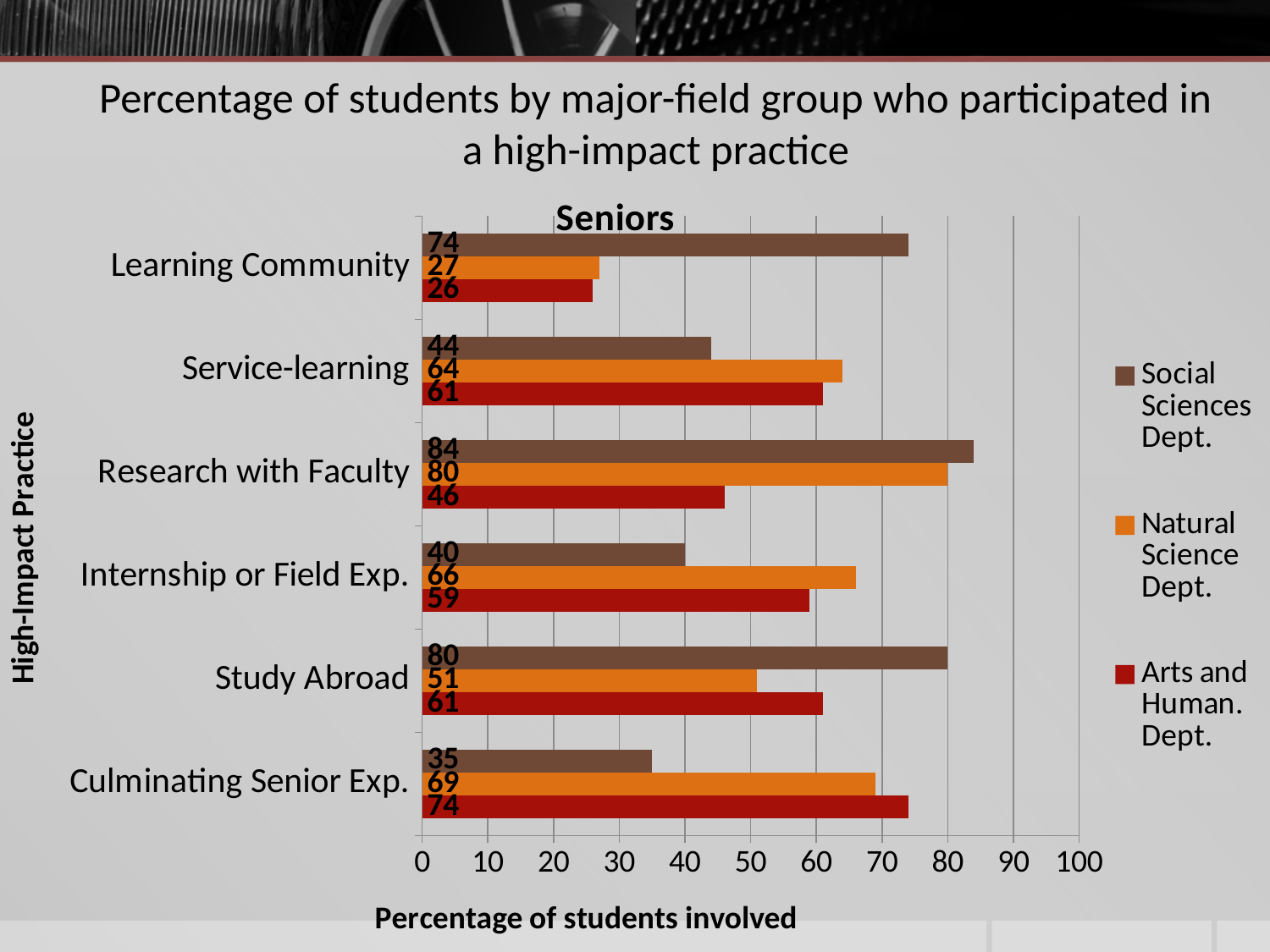
How many high-impact practice categories are shown on the chart? 6 Which category has the lowest value for the Arts and Human. Dept. series? Learning Community What is the value for Arts and Human. Dept. in the Research with Faculty category? 46 What is the value for Social Sciences Dept. in the Learning Community category? 74 How many series does the legend list? 3 For Study Abroad, which is larger: the Social Sciences Dept. value or the Arts and Human. Dept. value? Social Sciences Dept. What is the value for Natural Science Dept. in the Internship or Field Exp. category? 66 Is the Natural Science Dept. value for Service-learning greater or less than 50? greater Which category has the highest value for the Social Sciences Dept. series? Research with Faculty What is the label of the horizontal axis? Percentage of students involved What is the difference between the Natural Science Dept. and Social Sciences Dept. values for Culminating Senior Exp.? 34 What kind of chart is shown on the slide? Bar chart